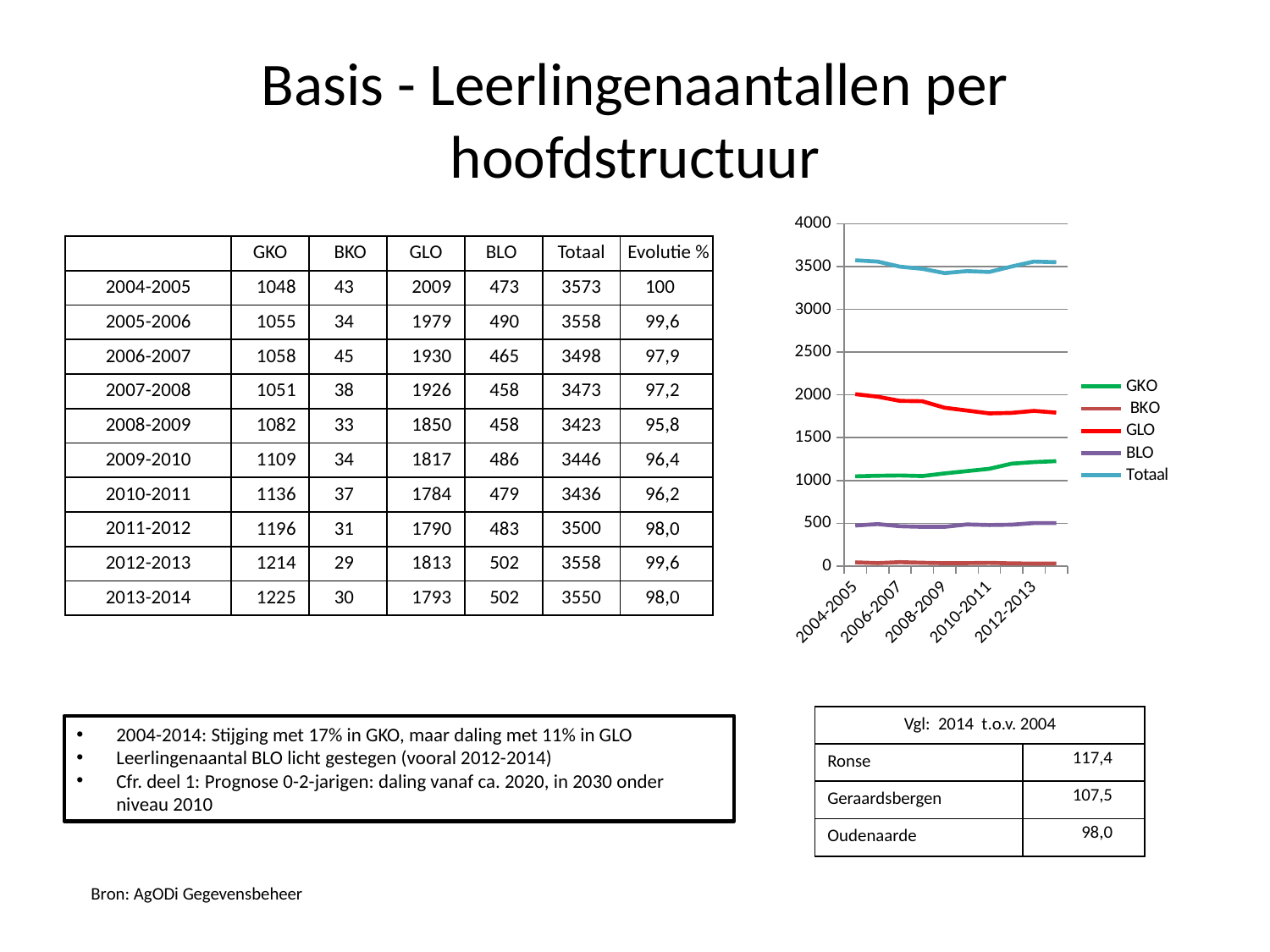
Does the GLO line rise or fall from 2004-2005 to 2013-2014? fall Which series in the chart has the highest values throughout? Totaal Is the value of the GLO line for 2012-2013 greater or less than 2000? less Is the value of the Totaal line for 2004-2005 greater or less than 3500? greater Is the value of the BLO line for 2008-2009 greater or less than 500? less What kind of chart is shown on the slide? line chart What is the Totaal value for 2004-2005, as printed in the table on the slide? 3573 Does the GKO line rise or fall from 2004-2005 to 2013-2014? rise Which series in the chart has the lowest values throughout? BKO How many series does the chart's legend list? 5 In 2004-2005, which is larger: the GLO value or the GKO value? GLO What colour is the Totaal line in the chart? light blue